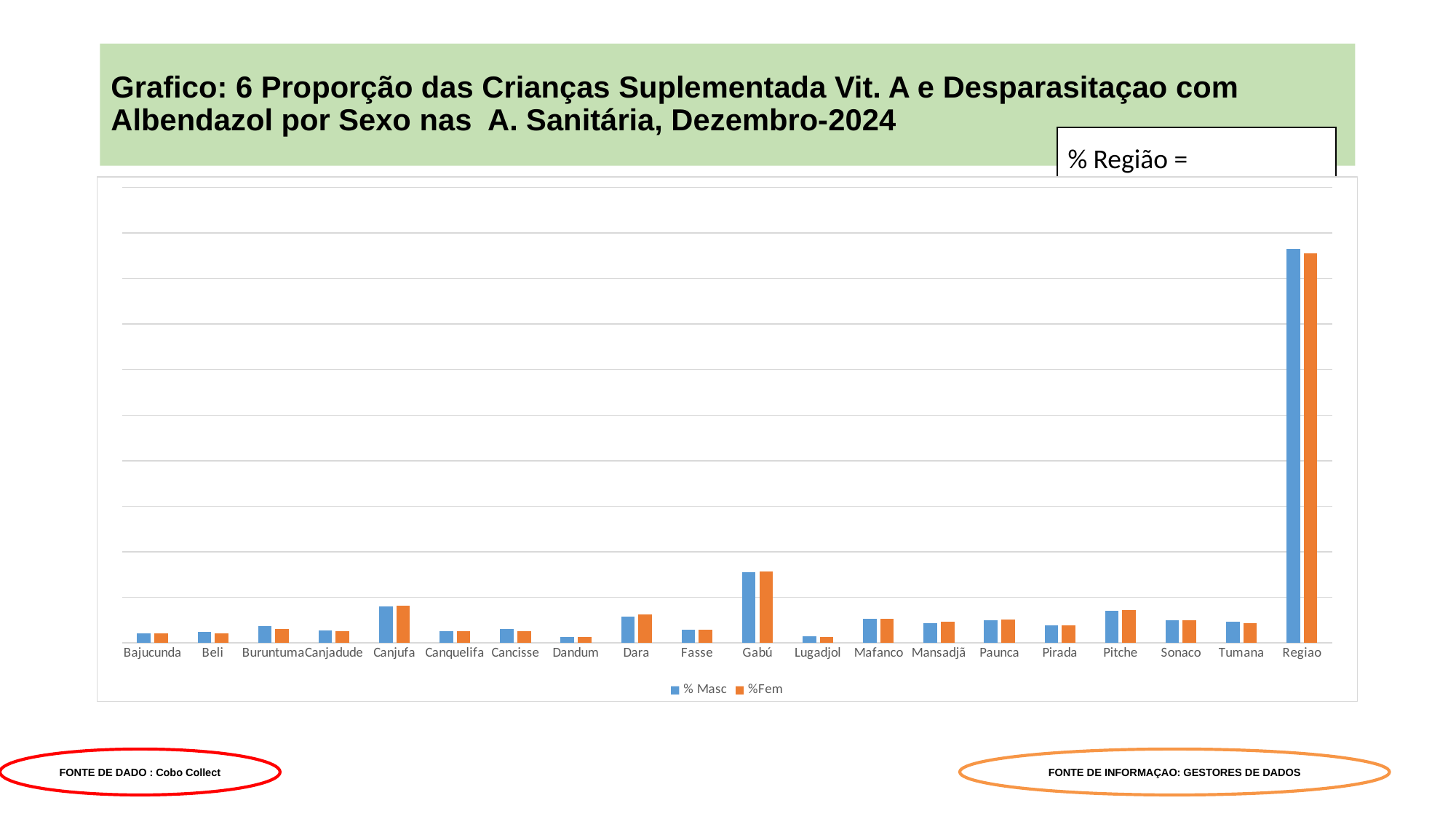
What are the two series named in the legend? % Masc and %Fem Excluding Regiao, which area has the highest % Masc value? Gabú Which category has the highest %Fem value? Regiao Which colour represents the %Fem series? Orange Which category has the highest % Masc value? Regiao How many categories are shown on the x axis of the chart? 20 Which is larger, the %Fem value for Pitche or for Pirada? Pitche How many series does the legend list? 2 What kind of chart is shown on the slide? Bar chart Which is larger, the %Fem value for Regiao or for Gabú? Regiao Which is larger, the % Masc value for Canjufa or for Dara? Canjufa